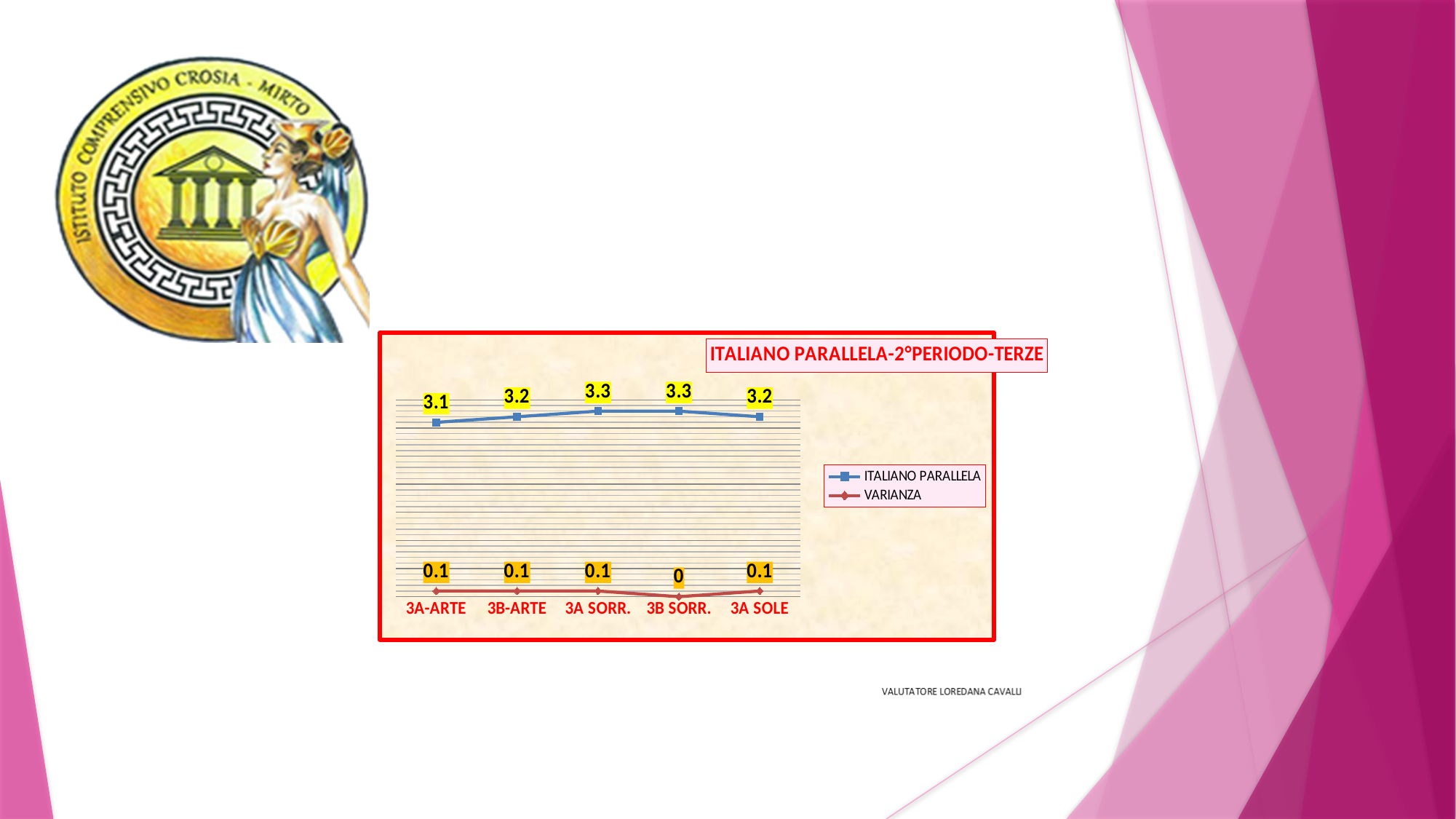
What kind of chart is shown? line chart Which category has the lowest VARIANZA value? 3B SORR. Which is larger, the ITALIANO PARALLELA value for 3B-ARTE or for 3B SORR.? 3B SORR. What is the VARIANZA value for 3B-ARTE? 0.1 How many series does the legend list? 2 Which category has the lowest ITALIANO PARALLELA value? 3A-ARTE What is the ITALIANO PARALLELA value for 3A SOLE? 3.2 What is the ITALIANO PARALLELA value for 3A-ARTE? 3.1 What is the difference between the ITALIANO PARALLELA values for 3A SORR. and 3A-ARTE? 0.2 What is the VARIANZA value for 3B SORR.? 0 How many categories are shown on the x axis? 5 What is the title of the chart? ITALIANO PARALLELA-2°PERIODO-TERZE